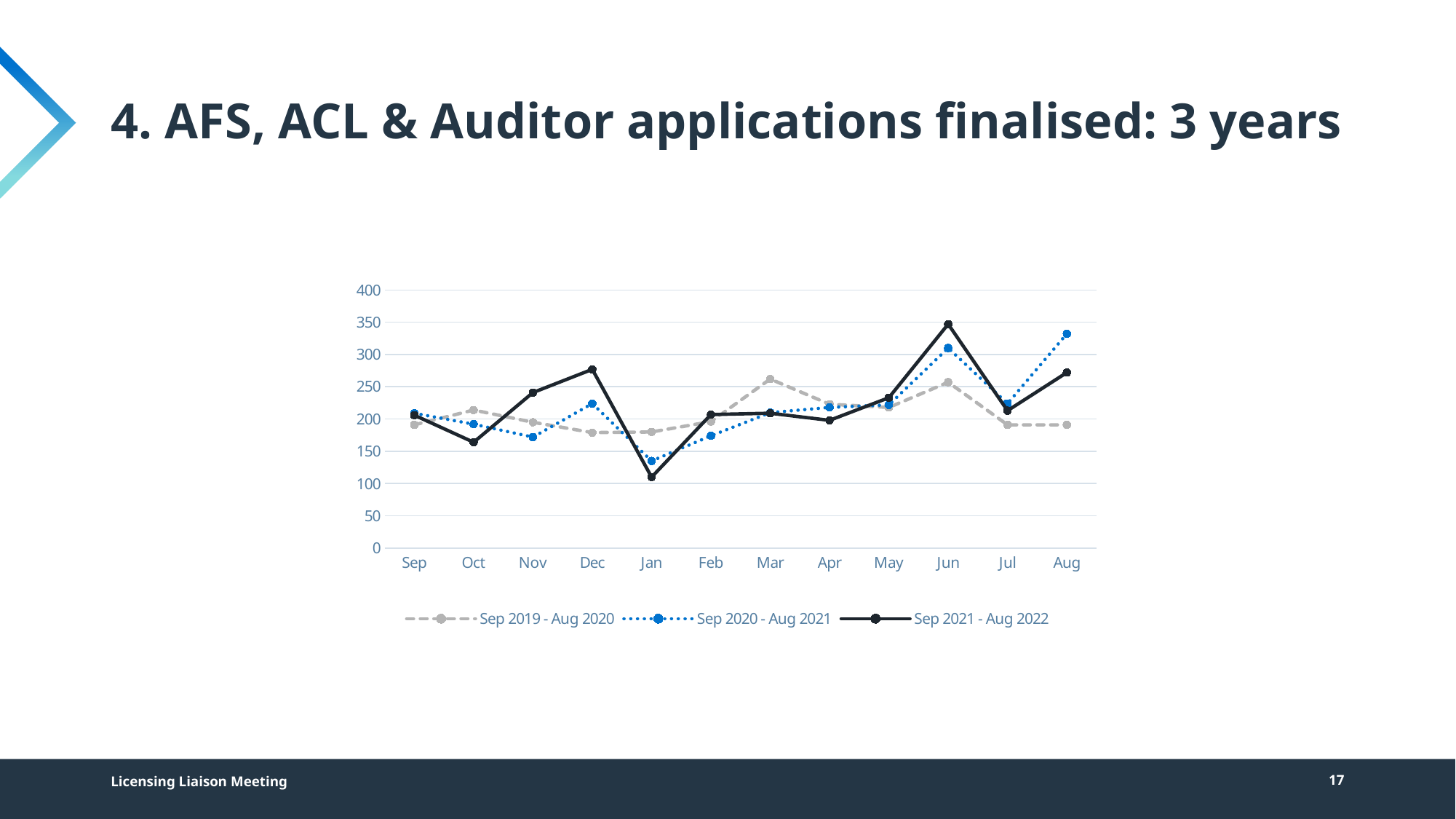
Does the Sep 2021 - Aug 2022 series rise or fall from Jun to Jul? fall In Aug, which series has the larger value: Sep 2020 - Aug 2021 or Sep 2021 - Aug 2022? Sep 2020 - Aug 2021 Is the value for Sep 2021 - Aug 2022 in Jun greater or less than 300? greater In which month does the Sep 2020 - Aug 2021 series reach its highest value? Aug How many series does the legend list? 3 What kind of chart is shown on the slide? line chart In which month does the Sep 2021 - Aug 2022 series reach its highest value? Jun In which month does the Sep 2020 - Aug 2021 series reach its lowest value? Jan Is the value for Sep 2021 - Aug 2022 in Jan greater or less than 150? less In Dec, which series has the larger value: Sep 2019 - Aug 2020 or Sep 2021 - Aug 2022? Sep 2021 - Aug 2022 How many months are shown along the x axis? 12 In which month does the Sep 2021 - Aug 2022 series reach its lowest value? Jan